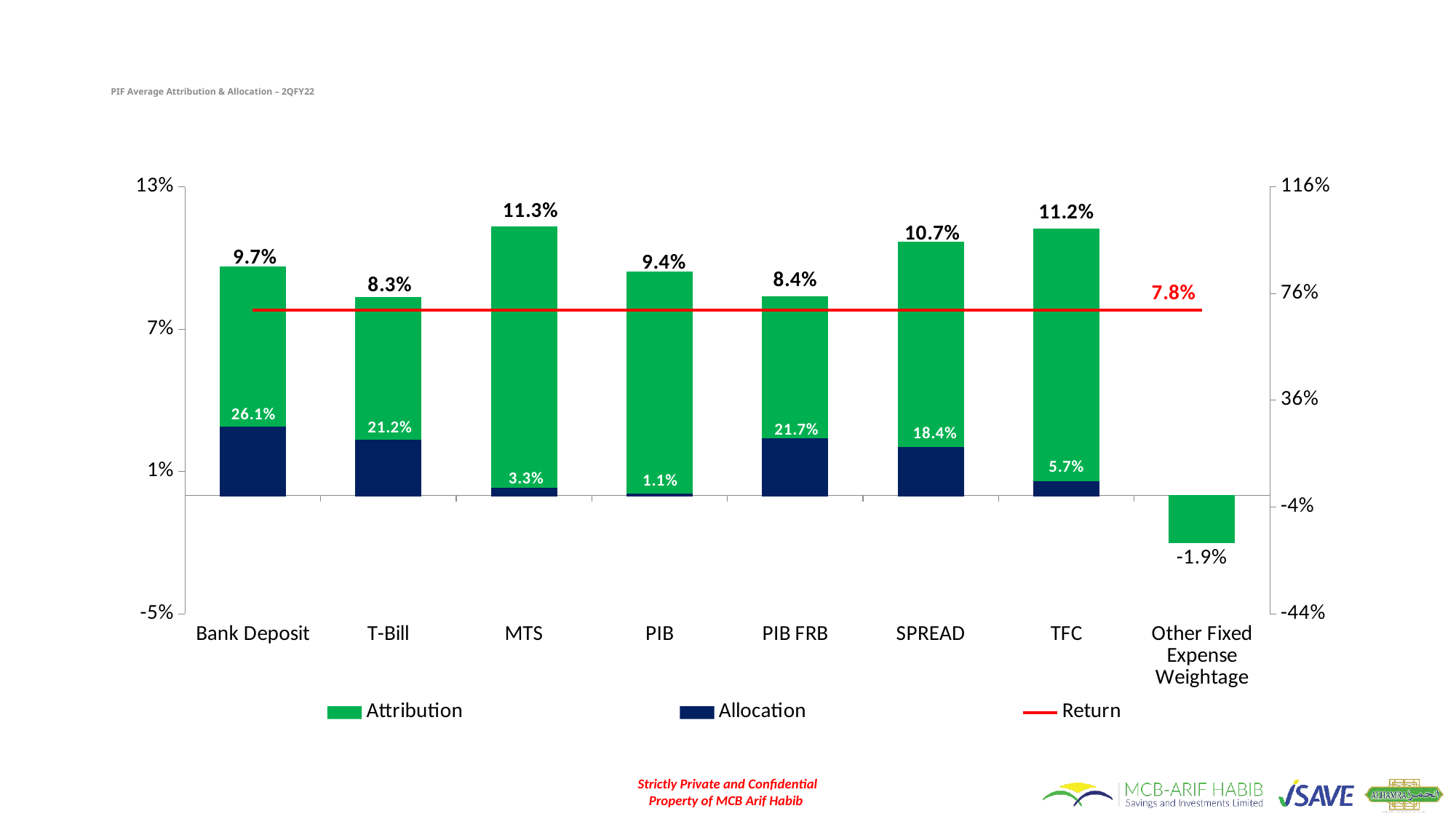
Which has a larger Allocation value, PIB FRB or SPREAD? PIB FRB How many series does the legend list? 3 Which category has the highest Allocation value? Bank Deposit What is the Return value shown by the red line? 7.8% Which category has the highest Attribution value? MTS What kind of chart is this? Bar chart with a line How many categories are shown on the x axis? 8 Which category has the lowest Allocation value? PIB What is the Allocation value for Bank Deposit? 26.1% What is the Attribution value for MTS? 11.3% What is the Attribution value for Other Fixed Expense Weightage? -1.9% What is the difference between the Attribution values for TFC and T-Bill? 2.9%